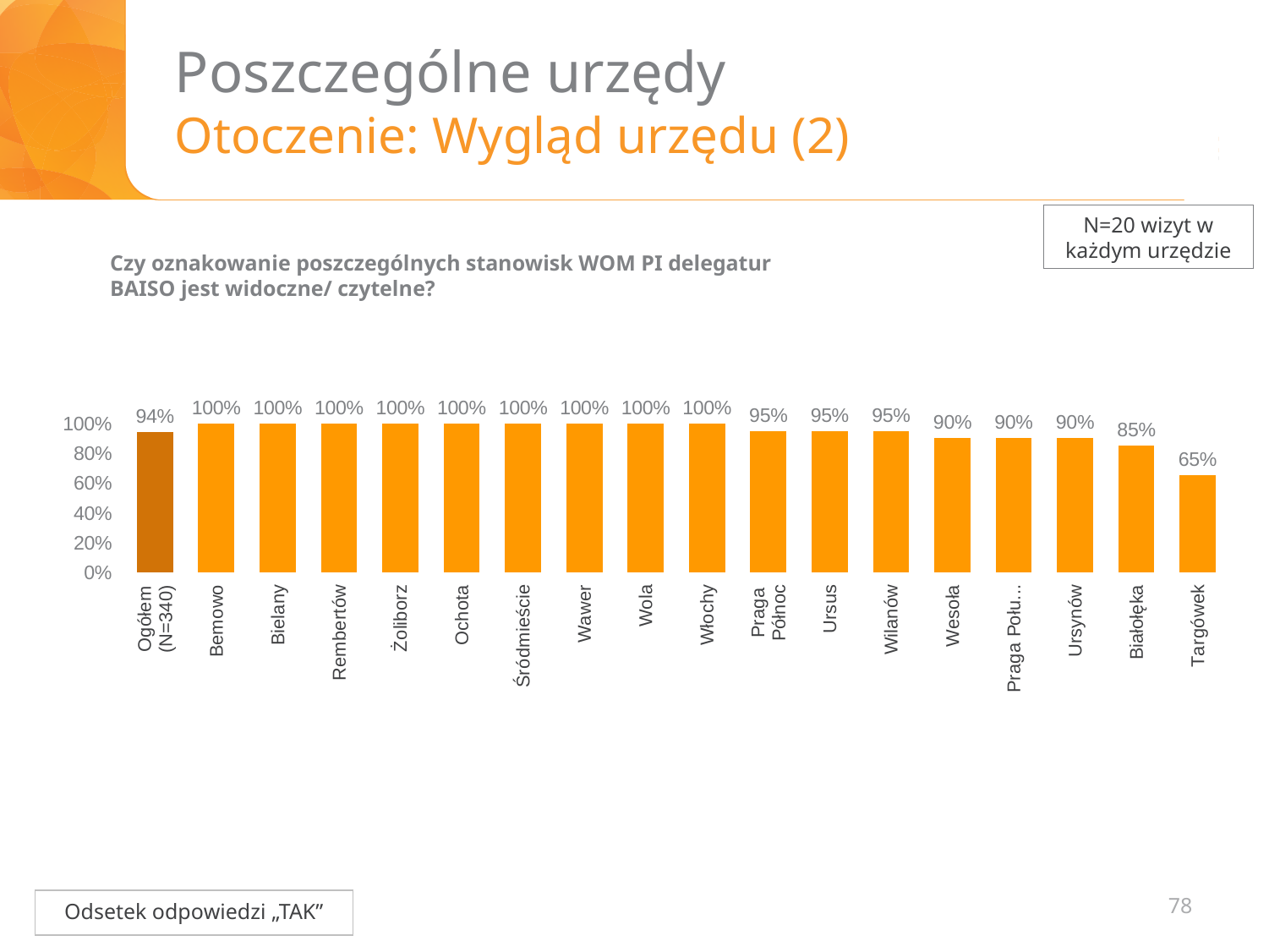
What is the difference between the values for Bemowo and Targówek? 35% What is the difference between the values for Ursynów and Białołęka? 5% Is the value for Targówek greater or less than 80%? less What kind of chart is shown on the slide? bar chart What is the value for Białołęka? 85% How many bars are shown in the chart? 18 What is the value for Ursus? 95% Which is larger, the value for Wilanów or the value for Wesoła? Wilanów What is the value for Ogółem (N=340)? 94% What is the value for Targówek? 65% Which category has the lowest value? Targówek What is the value for Wesoła? 90%